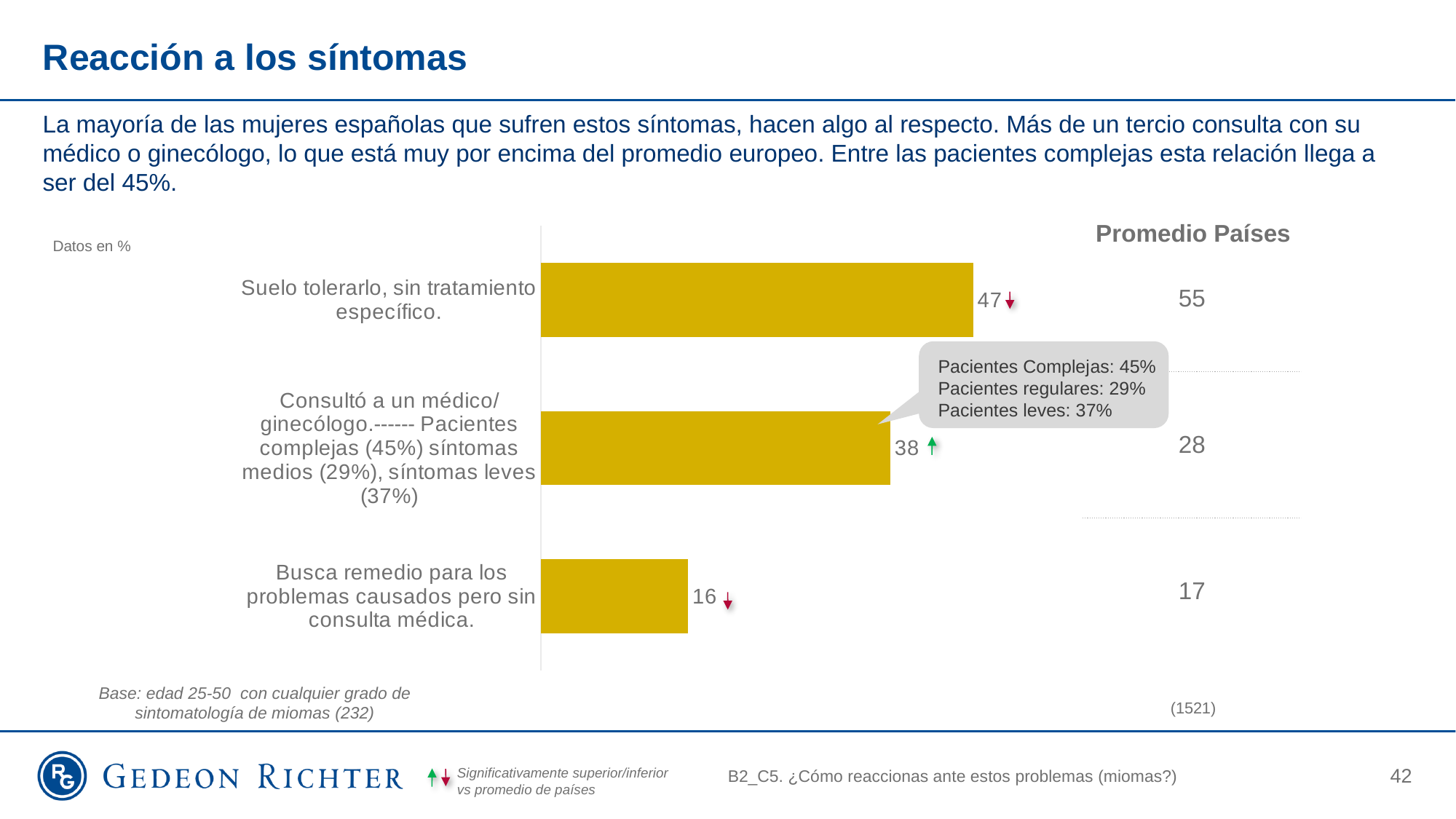
Which is larger: the value for "Suelo tolerarlo, sin tratamiento específico." or the value for "Consultó a un médico/ginecólogo"? Suelo tolerarlo, sin tratamiento específico. What is the title of the slide containing the chart? Reacción a los síntomas Which category has the highest value? Suelo tolerarlo, sin tratamiento específico. What is the difference between the value for "Suelo tolerarlo, sin tratamiento específico." and the value for "Busca remedio para los problemas causados pero sin consulta médica."? 31 What value is shown for the bar "Consultó a un médico/ginecólogo"? 38 What is the "Promedio Países" value for "Consultó a un médico/ginecólogo"? 28 What value is shown for "Suelo tolerarlo, sin tratamiento específico."? 47 What value is shown for "Busca remedio para los problemas causados pero sin consulta médica."? 16 How many categories (bars) does the chart show? 3 Which category has the lowest value? Busca remedio para los problemas causados pero sin consulta médica. What kind of chart is shown on the slide? Bar chart What is the "Promedio Países" value for "Suelo tolerarlo, sin tratamiento específico."? 55